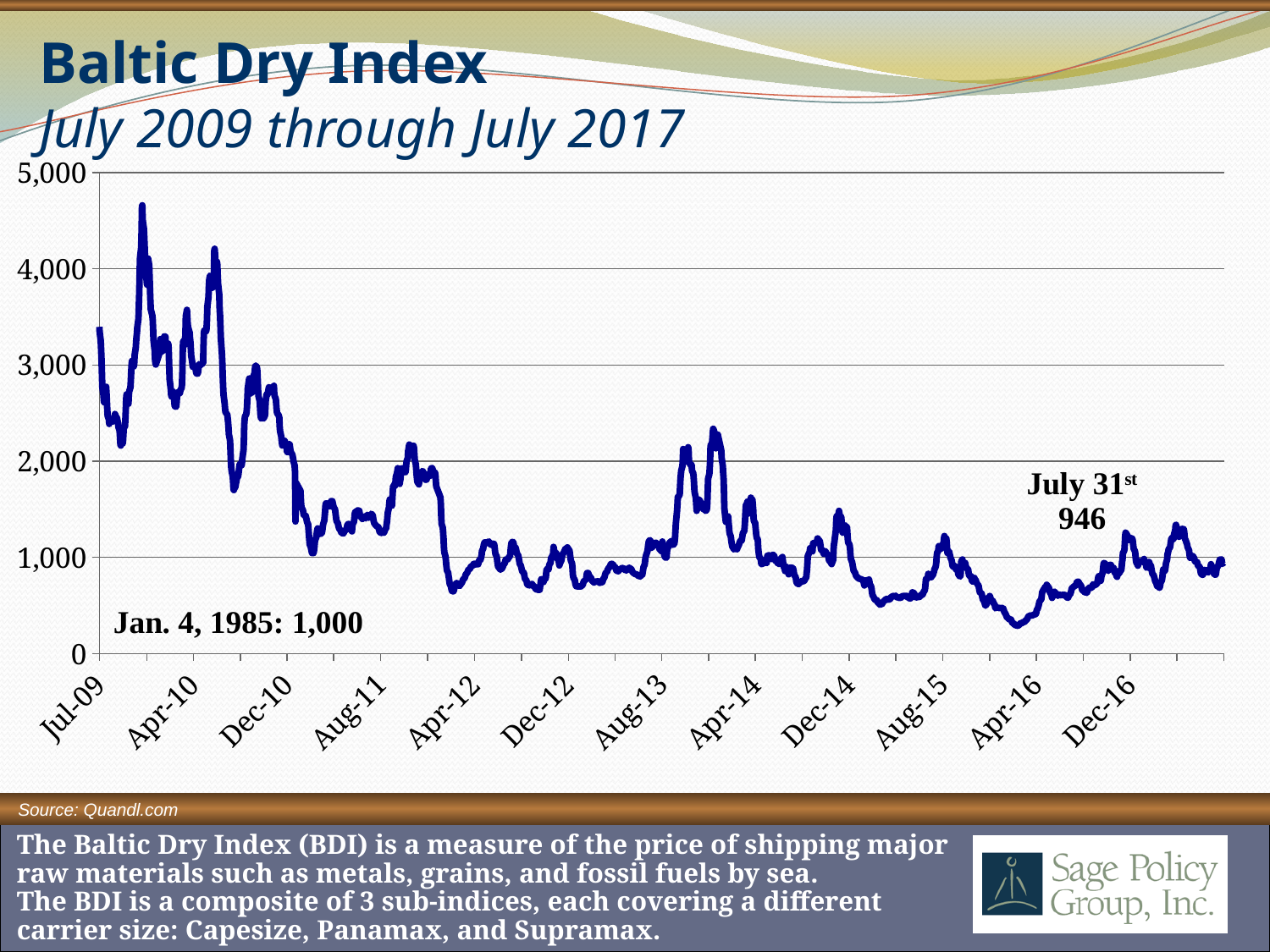
Overall, does the index rise or fall from Jul-09 to the end of the chart? fall Does the chart's highest point occur before or after Apr-10? before What is the title of the chart? Baltic Dry Index Is the value at Aug-11 greater or less than 2,000? less What kind of chart is shown on the slide? line chart Is the lowest point on the chart closer to Apr-16 or to Apr-12? Apr-16 What is the value of the Baltic Dry Index labelled for July 31st? 946 Is the value at Jul-09 greater or less than 3,000? greater Is the highest point on the chart greater or less than 4,000? greater Which is larger, the value at Jul-09 or the value at Dec-16? Jul-09 What value is given for the index on Jan. 4, 1985? 1,000